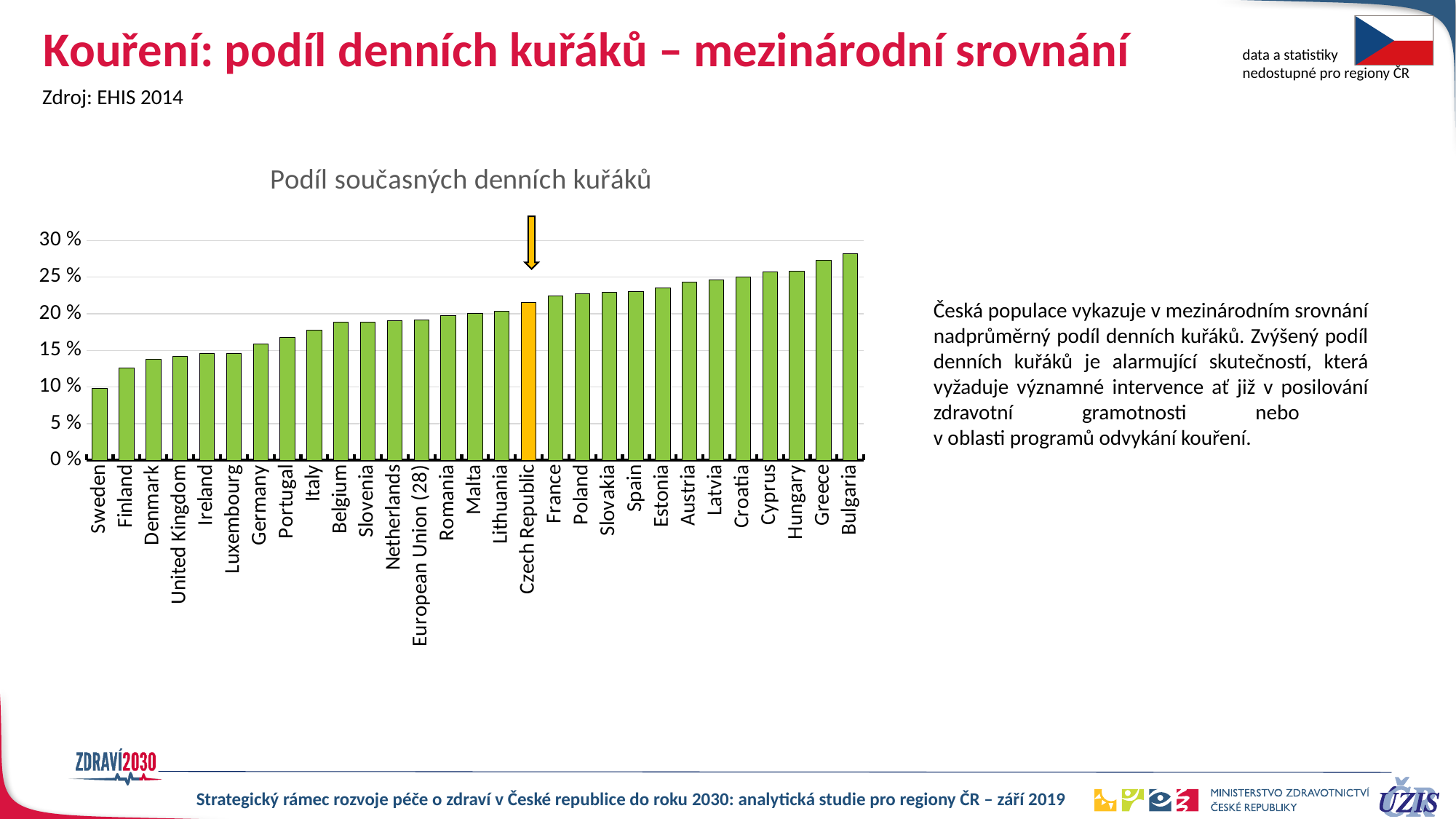
What kind of chart is shown on the slide? bar chart Is the value for Finland greater or less than 15 %? less What is the title of the chart? Podíl současných denních kuřáků Is the value for Czech Republic greater or less than 20 %? greater Do the values rise or fall moving from left to right along the x axis? rise Which category has the highest share of daily smokers in the chart? Bulgaria Is the value for Italy greater or less than 20 %? less Which category has the lowest share of daily smokers in the chart? Sweden Which has a larger share of daily smokers, Greece or Finland? Greece How many countries/categories are shown on the x axis of the chart? 29 Which country's bar is highlighted in a different colour (orange) from the others? Czech Republic